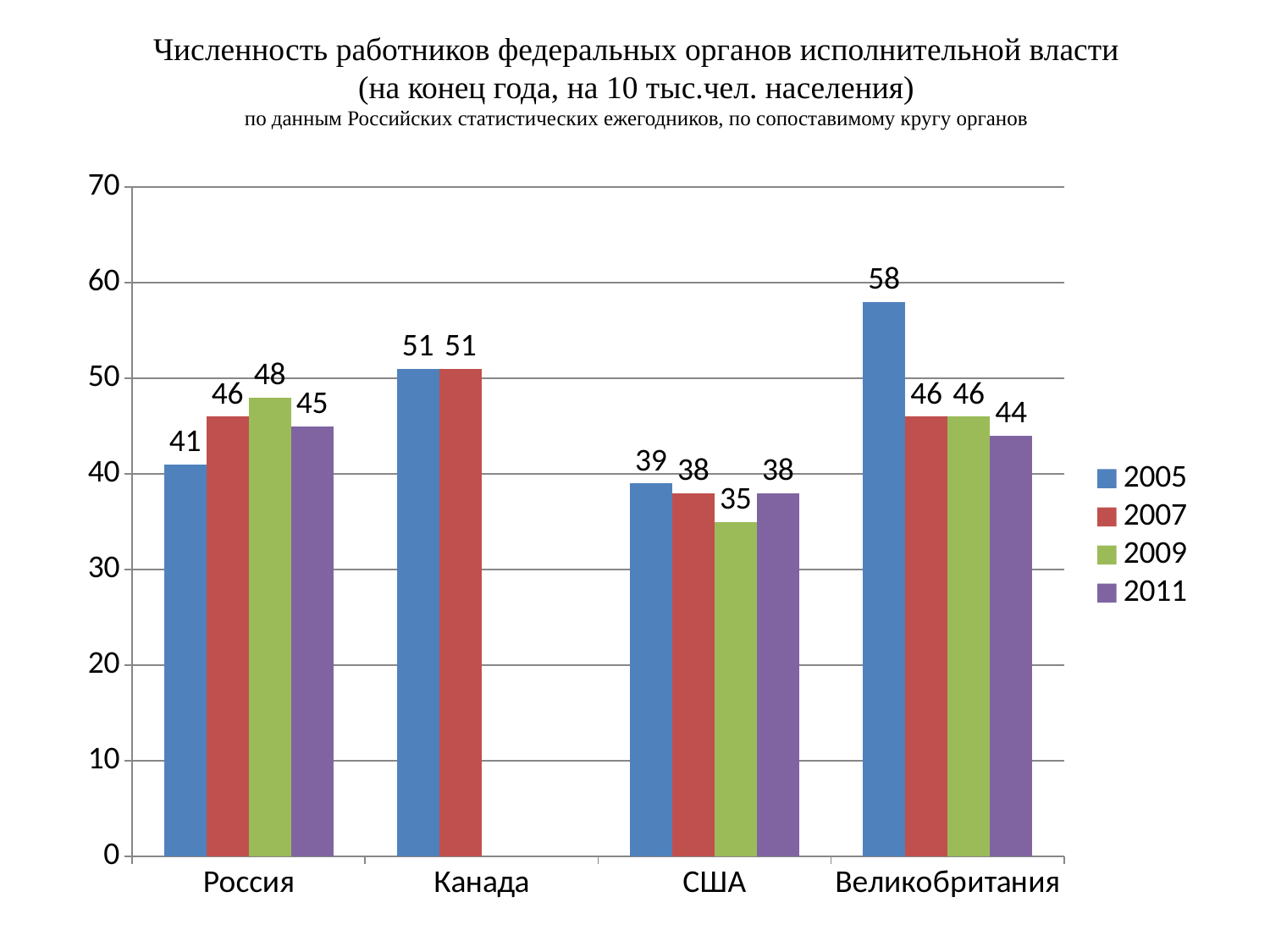
Is the 2005 value for Канада greater or less than 50? greater What is the difference between the 2005 and 2011 values for Великобритания? 14 What is the value for Великобритания in 2011? 44 Which country has the lowest value in 2007? США How many countries are shown on the x axis? 4 Which country has the highest value in 2005? Великобритания What is the value for США in 2009? 35 How many series does the legend list? 4 Which is larger: the 2009 value for Россия or the 2009 value for Великобритания? Россия What kind of chart is shown on the slide? bar chart What is the value for Россия in 2005? 41 Which year does the blue series represent? 2005